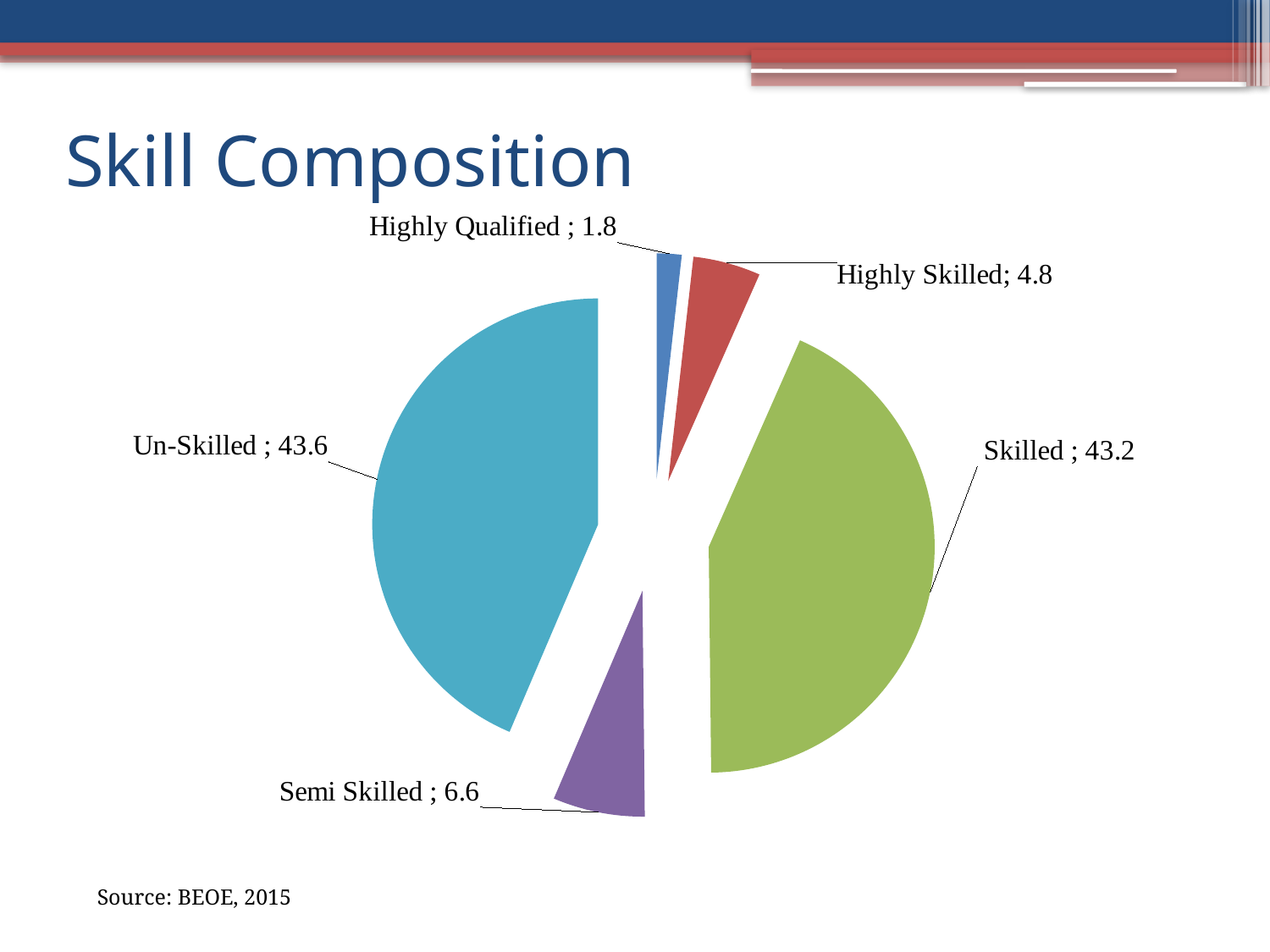
What is the difference between the values for Un-Skilled and Skilled? 0.4 What is the value for Highly Qualified in the pie chart? 1.8 What type of chart is shown on the slide? Pie chart Which category has the largest slice in the pie chart? Un-Skilled What is the title of the slide containing the pie chart? Skill Composition Which is larger, the value for Highly Skilled or the value for Semi Skilled? Semi Skilled What is the difference between the values for Highly Skilled and Highly Qualified? 3 What is the value for Skilled in the pie chart? 43.2 How many categories are shown in the pie chart? 5 Which category has the smallest slice in the pie chart? Highly Qualified What is the value for Un-Skilled in the pie chart? 43.6 What is the value for Semi Skilled in the pie chart? 6.6